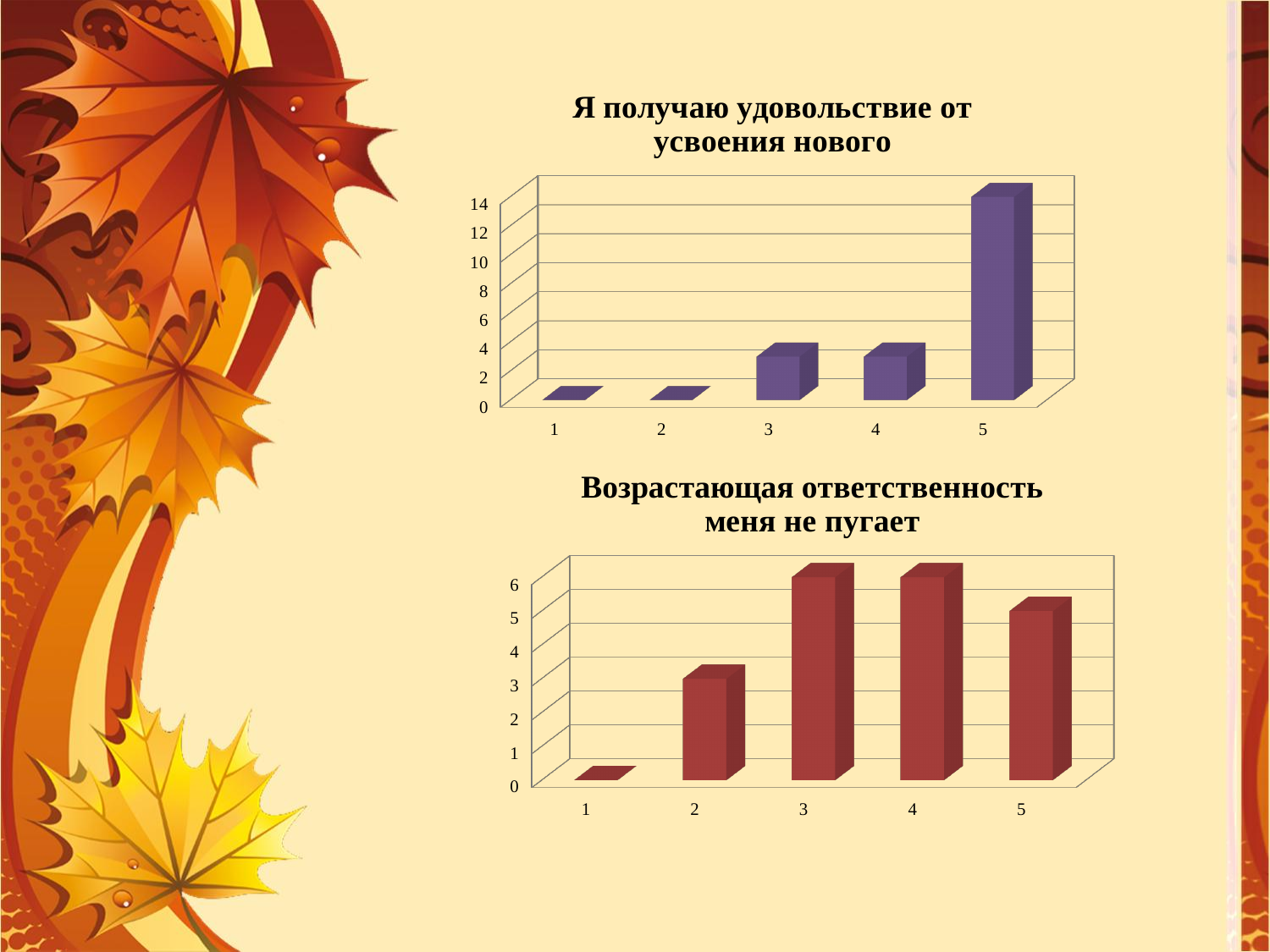
In the top chart "Я получаю удовольствие от усвоения нового", which is larger, the value for category 5 or the value for category 4? category 5 What kind of chart is the top chart titled "Я получаю удовольствие от усвоения нового"? bar chart In the top chart "Я получаю удовольствие от усвоения нового", is the value for category 3 greater or less than 4? less How many bars are shown in the bottom chart "Возрастающая ответственность меня не пугает"? 5 What is the title of the bottom chart on the slide? Возрастающая ответственность меня не пугает In the bottom chart "Возрастающая ответственность меня не пугает", is the value for category 3 greater or less than 5? greater In the bottom chart "Возрастающая ответственность меня не пугает", is the value for category 2 greater or less than 4? less In the bottom chart "Возрастающая ответственность меня не пугает", which category has the lowest bar? 1 In the bottom chart "Возрастающая ответственность меня не пугает", which is larger, the value for category 3 or the value for category 2? category 3 How many categories are shown on the x axis of the top chart "Я получаю удовольствие от усвоения нового"? 5 In the top chart "Я получаю удовольствие от усвоения нового", which category has the highest bar? 5